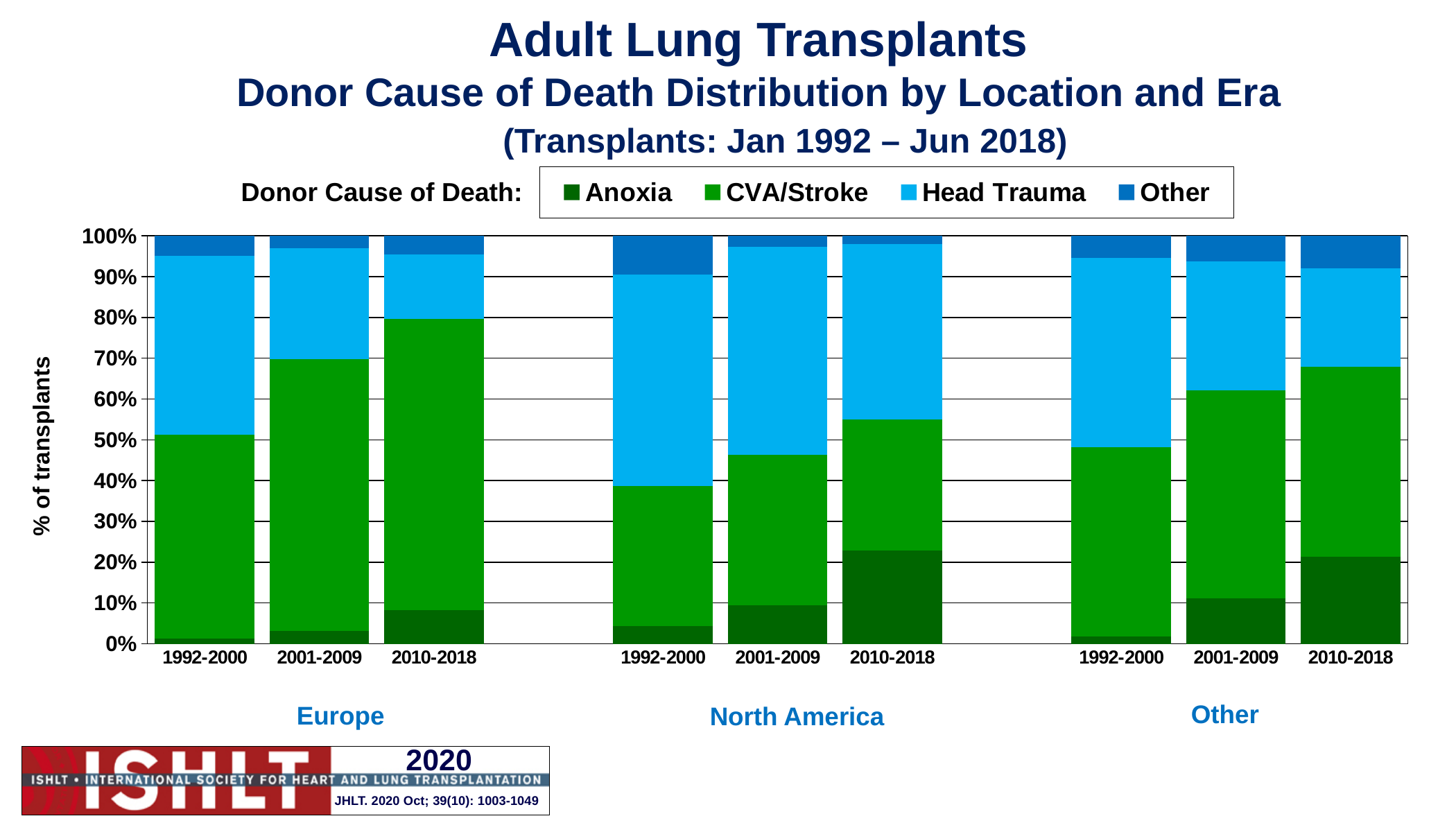
How many location groups are shown along the x axis? 3 How many series does the legend list? 4 What kind of chart is shown on the slide? Stacked bar chart Within North America, which era has the largest Anoxia share? 2010-2018 How many bars are plotted in the chart? 9 Across the eras within each location, does the Anoxia share rise or fall? rise Is the Anoxia share for Europe 2001-2009 greater or less than 10%? less Is the Anoxia share for North America 2010-2018 greater or less than 20%? greater What is the label on the y axis? % of transplants Which is larger, the Anoxia share for Europe 2010-2018 or for North America 2010-2018? North America 2010-2018 Is the Anoxia share for North America 1992-2000 greater or less than 10%? less Within Europe, which era has the smallest Anoxia share? 1992-2000